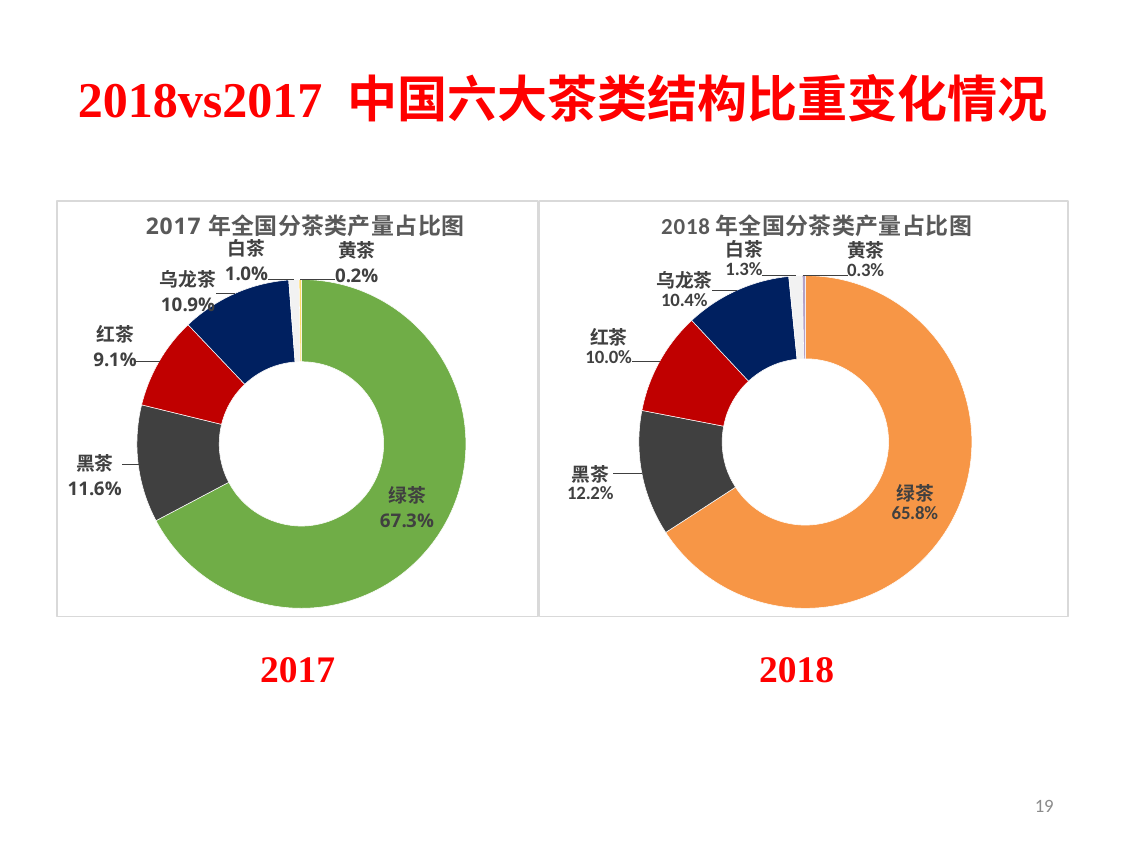
What type of chart is the 2017 chart (left)? Donut (pie) chart In the 2018 chart (right), what is the share for 黄茶? 0.3% In the 2017 chart (left), what is the share for 乌龙茶? 10.9% In the 2018 chart (right), what is the share for 黑茶? 12.2% In the 2018 chart (right), which tea category has the smallest share? 黄茶 In the 2017 chart (left), what is the share for 绿茶? 67.3% In the 2017 chart (left), which tea category has the largest share? 绿茶 In the 2018 chart (right), what is the difference between the shares of 黑茶 and 红茶? 2.2% How many tea categories are shown in the 2018 chart (right)? 6 In the 2017 chart (left), which is larger, the share of 黑茶 or the share of 红茶? 黑茶 In the 2018 chart (right), what colour is the 绿茶 slice? Orange What is the title of the chart on the right? 2018 年全国分茶类产量占比图